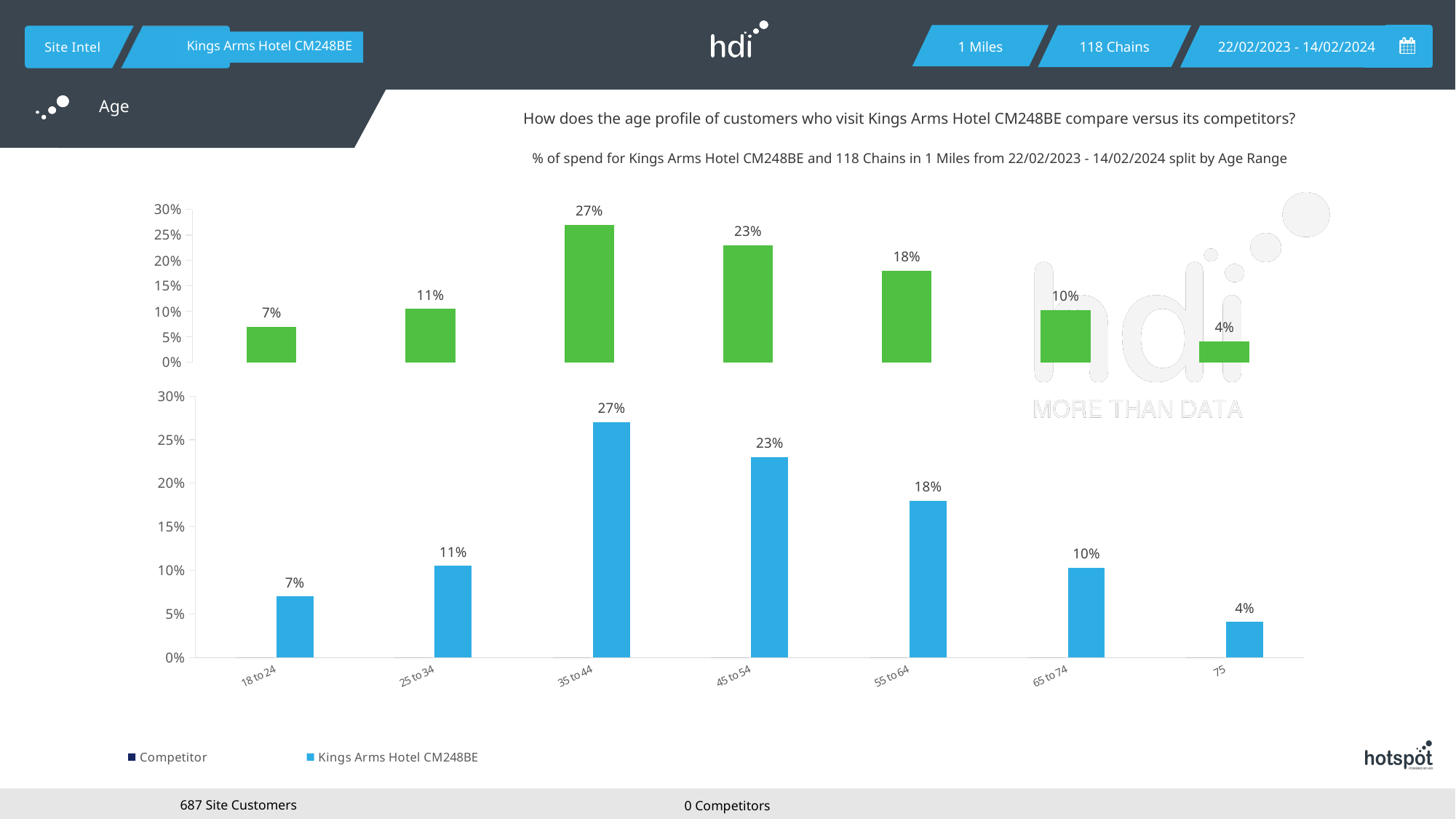
How many entries does the legend at the bottom of the slide list? 2 In the bottom chart (blue bars), which age range has the lowest value? 75 In the bottom chart (blue bars), what is the value for the 35 to 44 age range? 27% In the bottom chart (blue bars), what is the difference between the values for 45 to 54 and 55 to 64? 5% In the bottom chart (blue bars), how many age range categories are shown on the x axis? 7 In the bottom chart (blue bars), which is larger, the value for 25 to 34 or the value for 65 to 74? 25 to 34 In the top chart (green bars), what is the difference between the highest and lowest bar values? 23% In the top chart (green bars), what is the value shown on the rightmost bar? 4% In the top chart (green bars), what is the value shown on the third bar from the left? 27% In the bottom chart (blue bars), what is the value for the 18 to 24 age range? 7% What kind of chart is the bottom chart (blue bars)? Bar chart In the bottom chart (blue bars), which age range has the highest value? 35 to 44